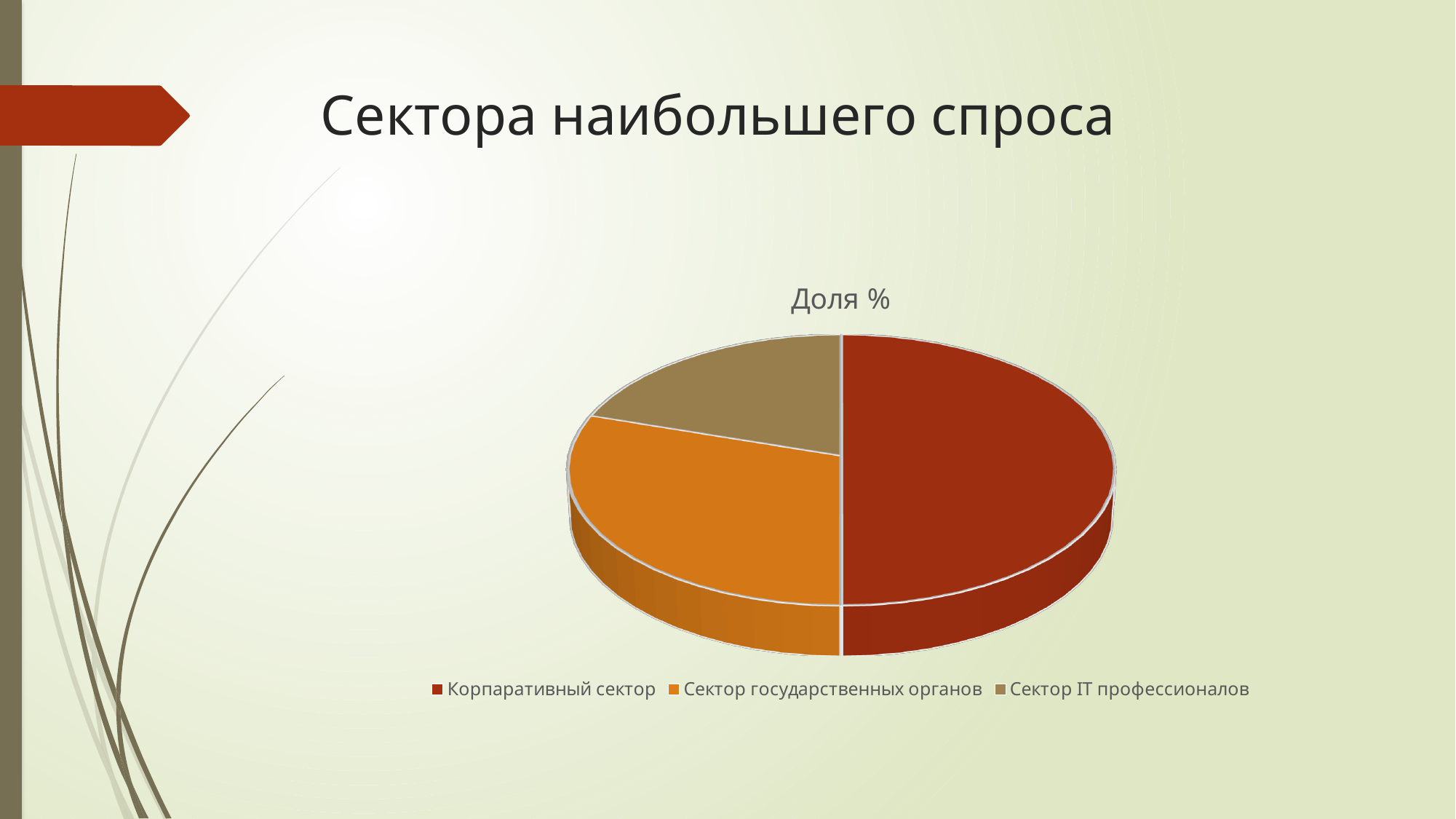
What kind of chart is shown on the slide? pie chart Which sector has the smallest slice of the pie? Сектор IT профессионалов Which sector has the largest slice of the pie? Корпаративный сектор What colour is the slice for Сектор государственных органов? orange How many entries does the chart legend list? 3 Which slice is larger: Сектор государственных органов or Сектор IT профессионалов? Сектор государственных органов How many slices does the pie chart have? 3 Which slice is smaller: Корпаративный сектор or Сектор IT профессионалов? Сектор IT профессионалов Which slice is larger: Корпаративный сектор or Сектор государственных органов? Корпаративный сектор What is the title of the chart? Доля %